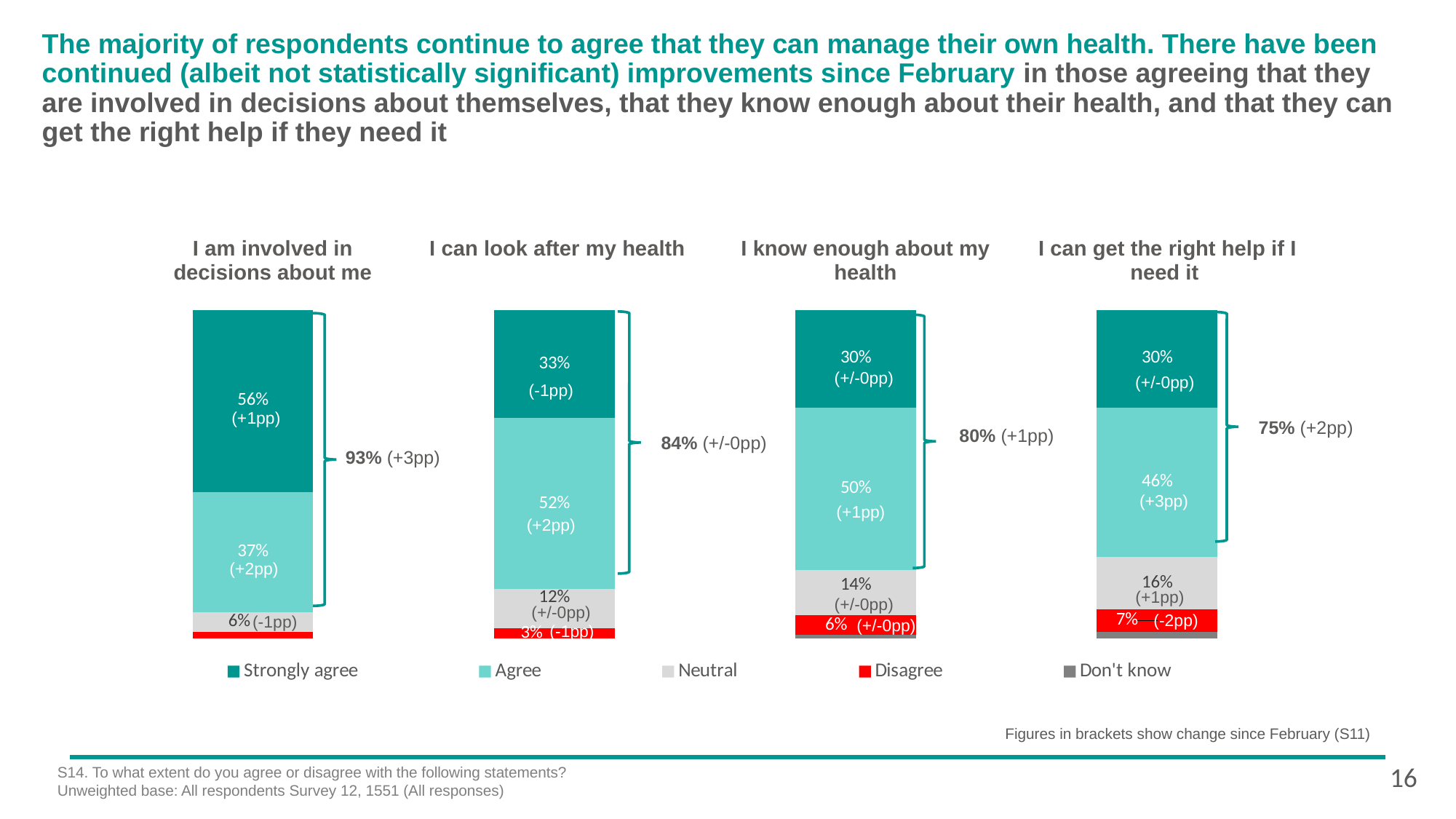
What is the change since February shown for the Agree segment of "I can get the right help if I need it"? +3pp What percentage of respondents strongly agree with the statement "I am involved in decisions about me"? 56% How many response categories does the legend list? 5 What type of chart is shown on the slide? Stacked bar chart What percentage of respondents agree (not strongly) with the statement "I can look after my health"? 52% What is the difference between the combined agreement figures for "I am involved in decisions about me" and "I can get the right help if I need it"? 18 percentage points Which is larger: the Strongly agree share for "I am involved in decisions about me" or for "I can look after my health"? I am involved in decisions about me Which statement has the highest combined agreement figure? I am involved in decisions about me What is the combined agreement figure shown for "I know enough about my health"? 80% Which statement has the lowest combined agreement figure? I can get the right help if I need it What percentage of respondents are neutral on "I can get the right help if I need it"? 16% How many statements are shown in the chart? 4